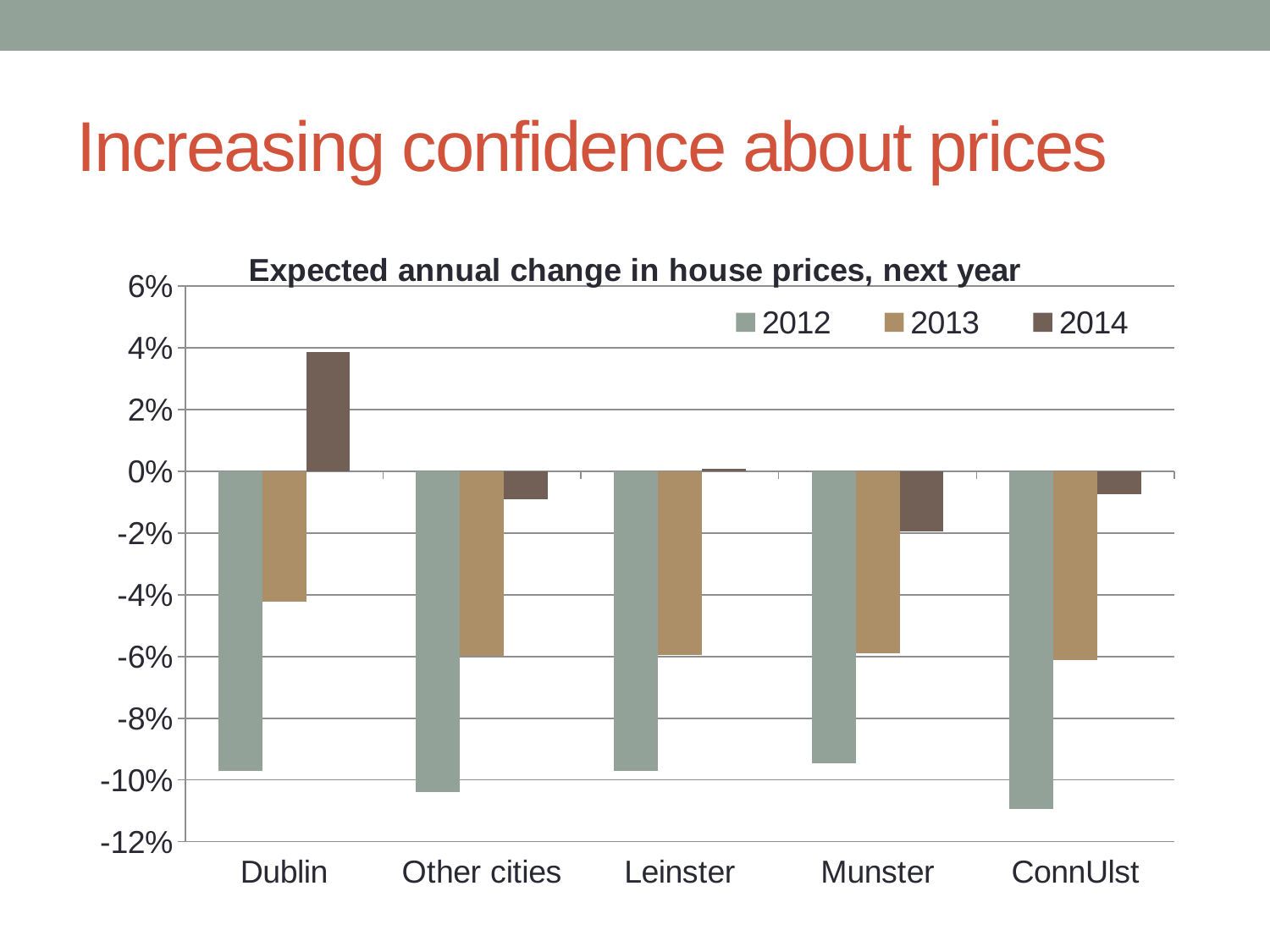
How many series does the legend list? 3 Is the 2014 value for Dublin greater or less than 2%? greater Which region has the highest value for 2014? Dublin Which region has the highest value for 2013? Dublin Is the 2012 value for Dublin greater or less than -8%? less Which region has the lowest value for 2012? ConnUlst Is the 2013 value for Dublin greater or less than -6%? greater What is the title of the chart? Expected annual change in house prices, next year What kind of chart is shown on the slide? bar chart For Dublin, do the values rise or fall from 2012 to 2014? rise Which is larger, the 2013 value for Dublin or the 2013 value for Other cities? Dublin How many regions are shown on the x axis? 5